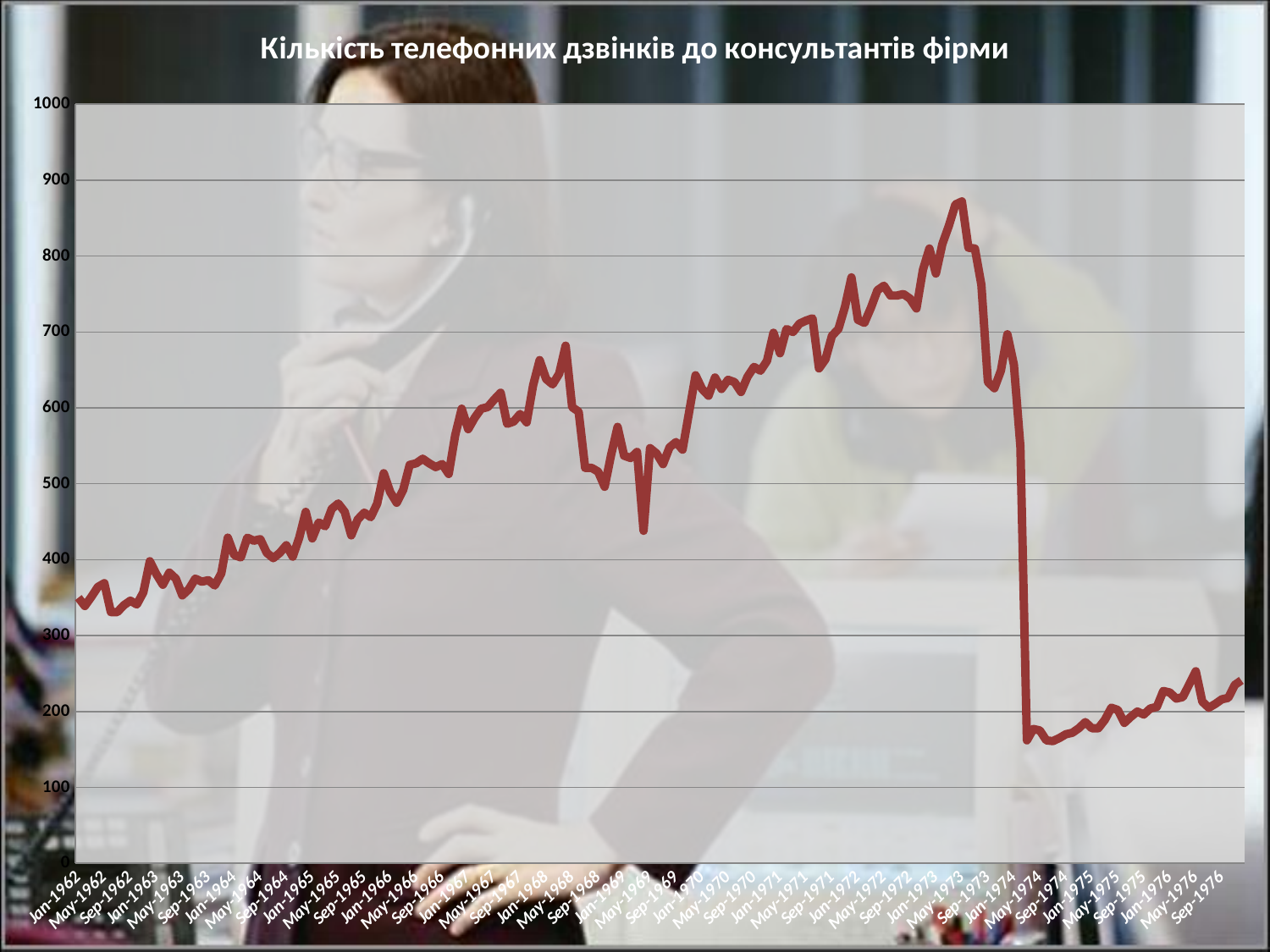
In which year does the line show a sharp drop from above 600 to below 200? 1974 What kind of chart is shown on the slide? line chart What is the highest value shown on the vertical axis of the chart? 1000 Is the value for Jan-1962 greater or less than 400? less Is the value for Jan-1962 greater or less than 300? greater What is the title of the chart? Кількість телефонних дзвінків до консультантів фірми Is the value for Jan-1970 greater or less than 500? greater Which is larger, the value for Jan-1973 or the value for Jan-1975? Jan-1973 Do the values generally rise or fall from Jan-1962 to Jan-1973? rise